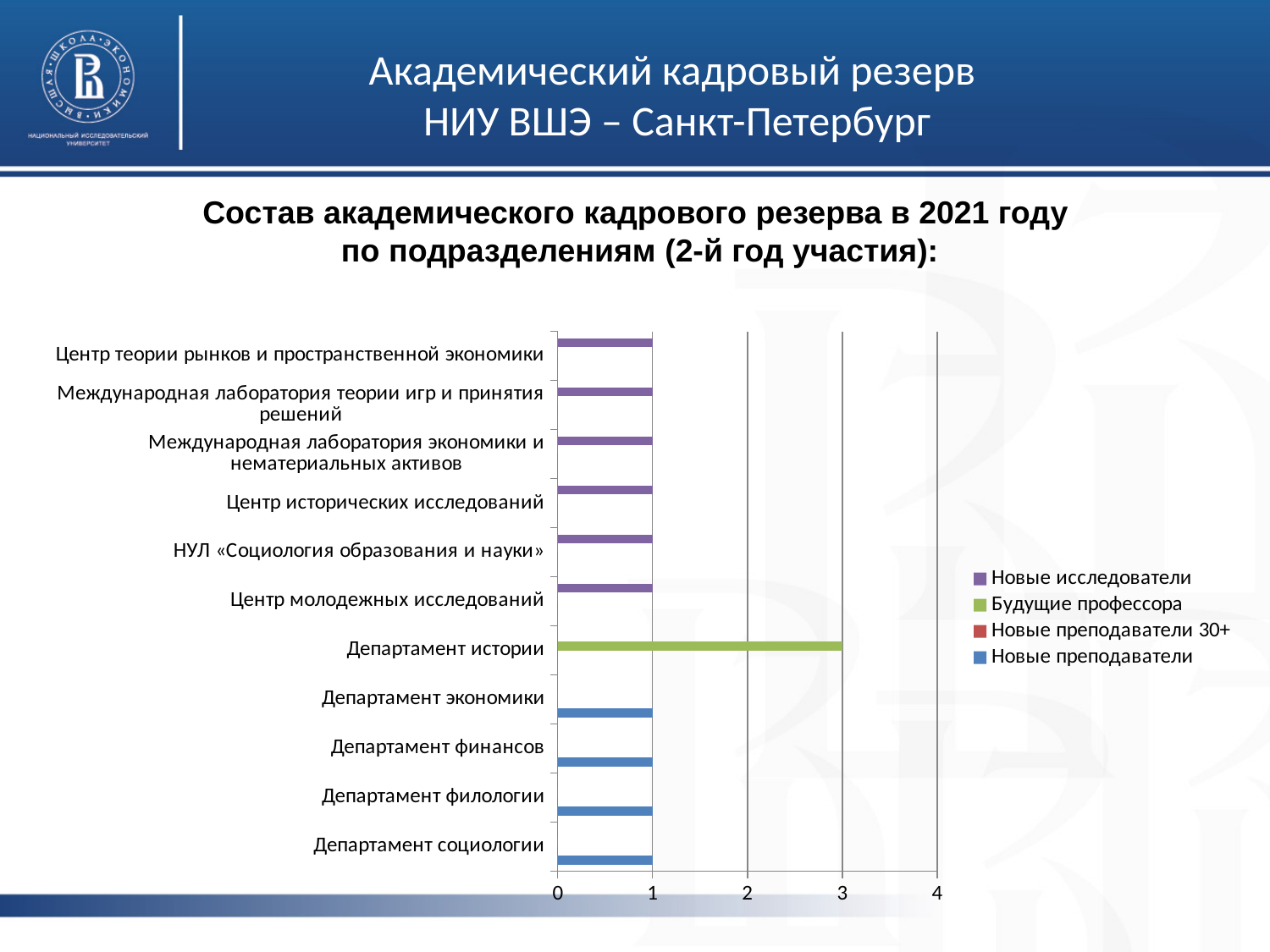
Is the value for Департамент истории greater or less than 2? greater What is the difference between the values for Департамент истории and Департамент финансов? 2 What is the value of the bar for Департамент экономики? 1 Which is larger: the value for Департамент истории or the value for Департамент социологии? Департамент истории Which legend series do the bars for Центр исторических исследований and НУЛ «Социология образования и науки» belong to? Новые исследователи What is the value of the bar for Департамент истории? 3 What is the value of the bar for Центр молодежных исследований? 1 Which category has the longest bar in the chart? Департамент истории What kind of chart is shown on the slide? bar chart How many series does the chart legend list? 4 Which legend series does the bar for Департамент истории belong to? Будущие профессора How many categories (units) are listed on the vertical axis of the chart? 11